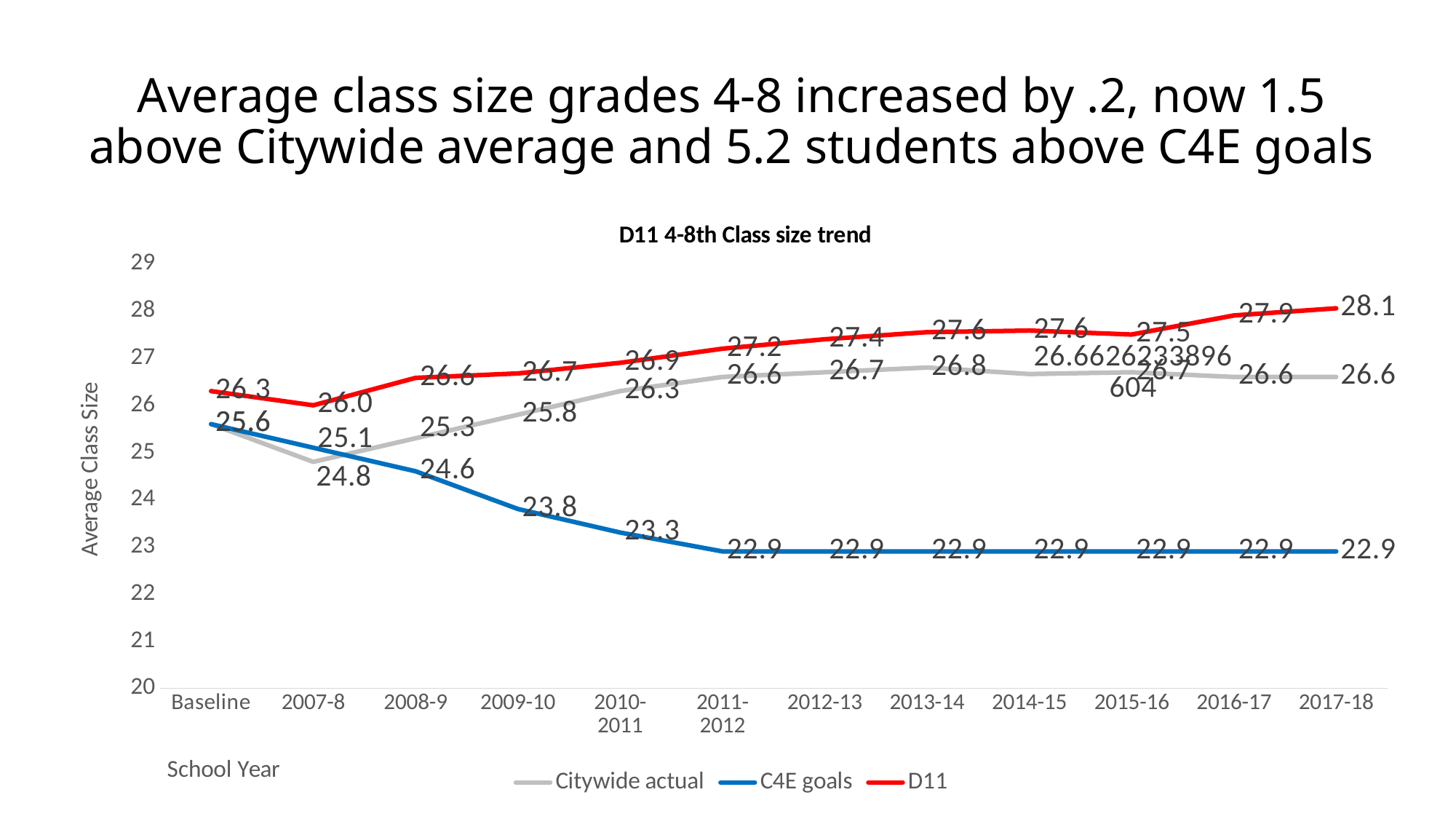
What is the C4E goals value for 2009-10? 23.8 In which school year is the D11 series at its highest? 2017-18 Is the Citywide actual value for 2014-15 greater or less than 26? greater What is the difference between the D11 value and the Citywide actual value in 2017-18? 1.5 In which school year is the D11 series at its lowest? 2007-8 What is the difference between the D11 value and the C4E goals value in 2017-18? 5.2 What kind of chart is this? line chart What is the D11 value for 2017-18? 28.1 How many school years are shown on the x axis? 12 Which is larger in 2012-13, the D11 value or the C4E goals value? D11 How many series does the legend list? 3 What is the Citywide actual value for 2007-8? 24.8